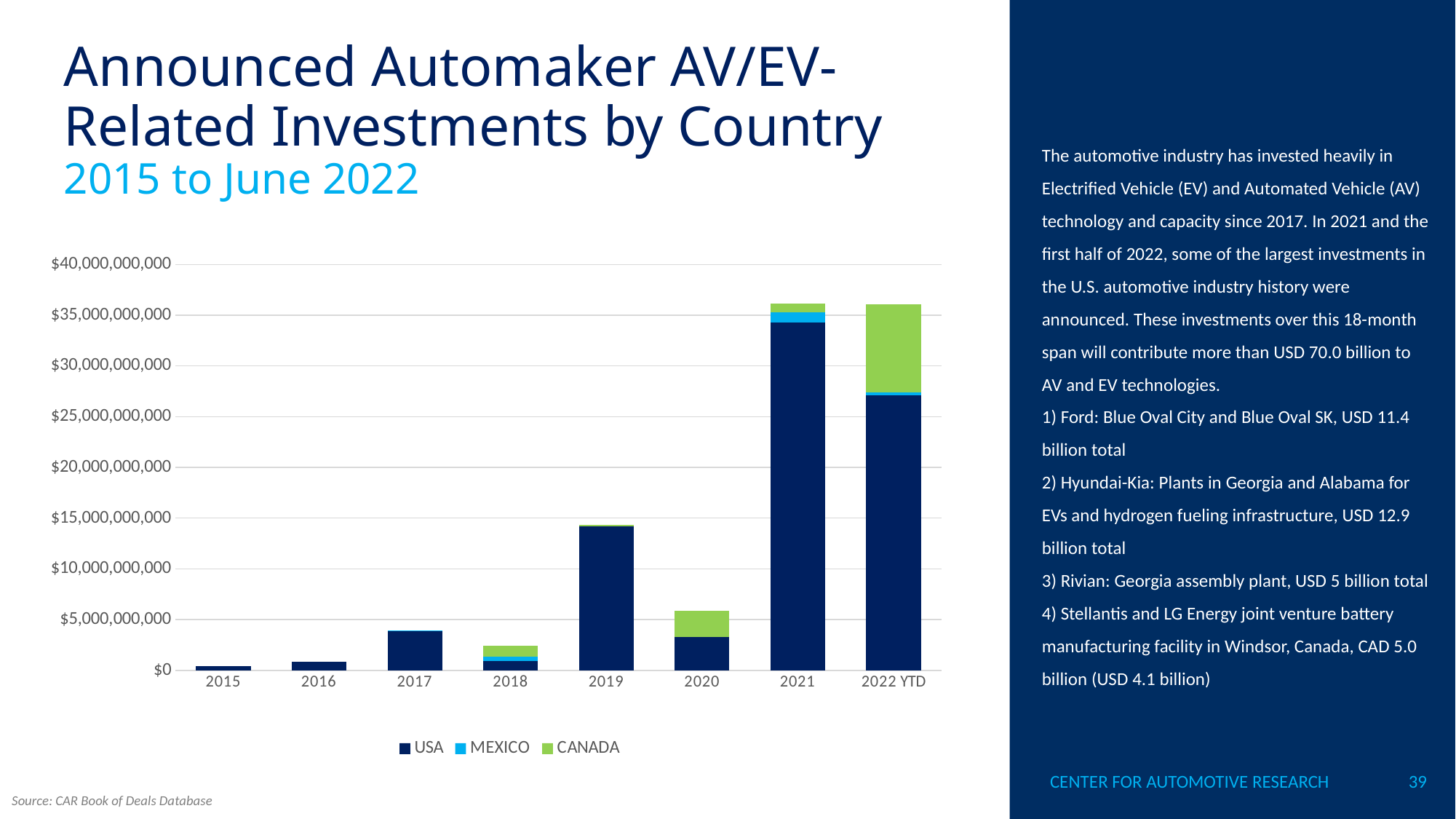
Which year has the larger total investment, 2019 or 2020? 2019 Which series is shown in green in the legend? CANADA How many year categories are shown on the x axis? 8 Is the USA value for 2022 YTD greater or less than $25,000,000,000? greater Do the total investments generally rise or fall from 2015 to 2022 YTD? rise Is the total investment for 2019 greater or less than $10,000,000,000? greater In which year is the CANADA segment the largest? 2022 YTD What kind of chart is shown on the slide? Stacked bar chart How many series does the legend list? 3 Which year has the lowest total announced investment? 2015 In which year is the USA segment the largest? 2021 Is the total investment for 2020 greater or less than $10,000,000,000? less